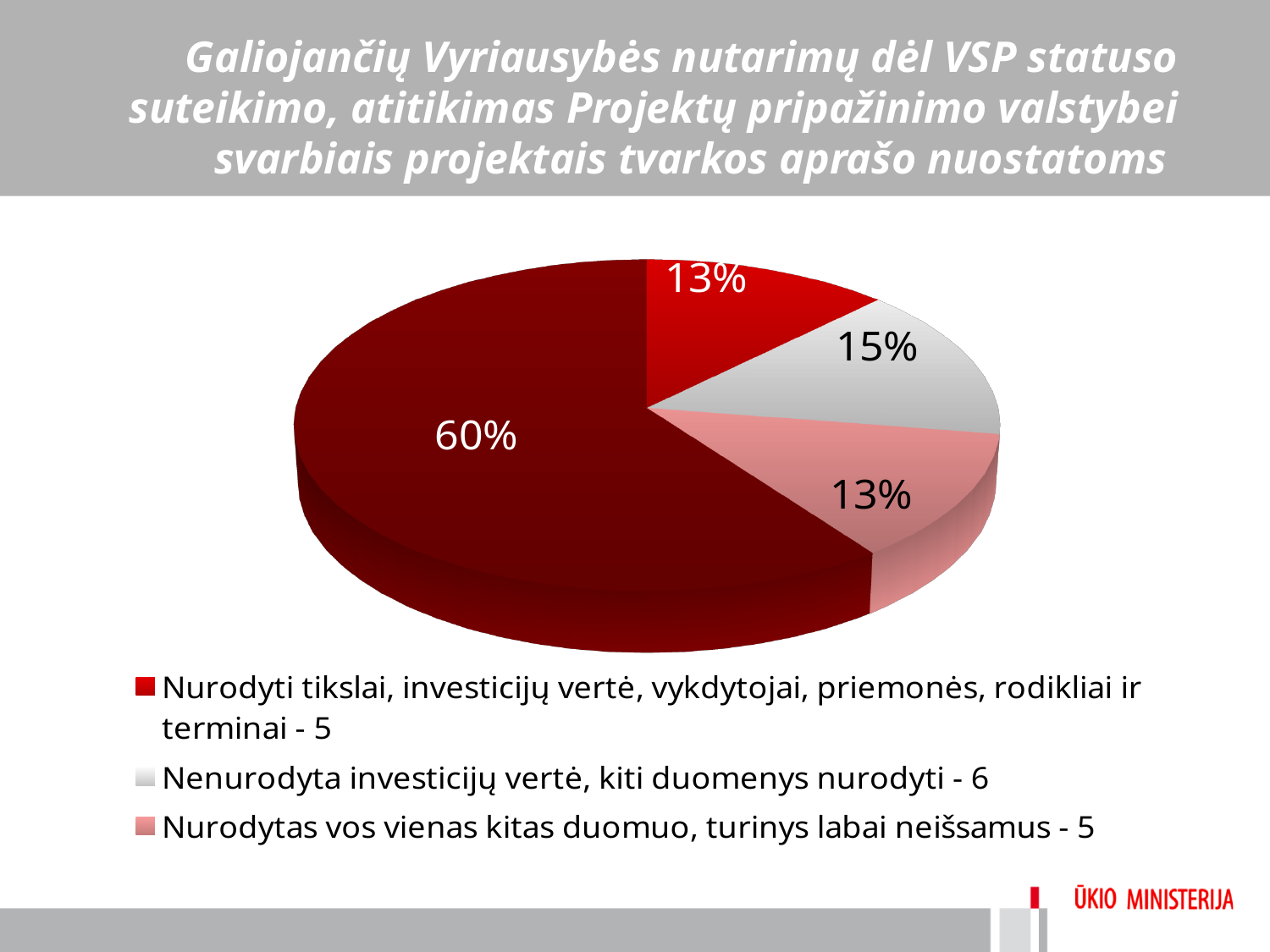
What is the smallest percentage shown on the pie chart? 13% What percentage is shown for the slice "Nurodytas vos vienas kitas duomuo, turinys labai neišsamus - 5"? 13% How many slices does the pie chart have? 4 What is the difference in percentage points between the "Nenurodyta investicijų vertė, kiti duomenys nurodyti - 6" slice and the "Nurodyti tikslai, investicijų vertė, vykdytojai, priemonės, rodikliai ir terminai - 5" slice? 2 What type of chart is shown on the slide? pie chart How many entries does the legend list? 3 What colour is the largest slice of the pie chart? dark red Which slice is larger: "Nenurodyta investicijų vertė, kiti duomenys nurodyti - 6" or "Nurodytas vos vienas kitas duomuo, turinys labai neišsamus - 5"? Nenurodyta investicijų vertė, kiti duomenys nurodyti - 6 What percentage is shown for the slice "Nurodyti tikslai, investicijų vertė, vykdytojai, priemonės, rodikliai ir terminai - 5"? 13% What number appears at the end of the legend entry "Nenurodyta investicijų vertė, kiti duomenys nurodyti"? 6 What percentage is shown for the slice "Nenurodyta investicijų vertė, kiti duomenys nurodyti - 6"? 15% What is the largest percentage shown on the pie chart? 60%